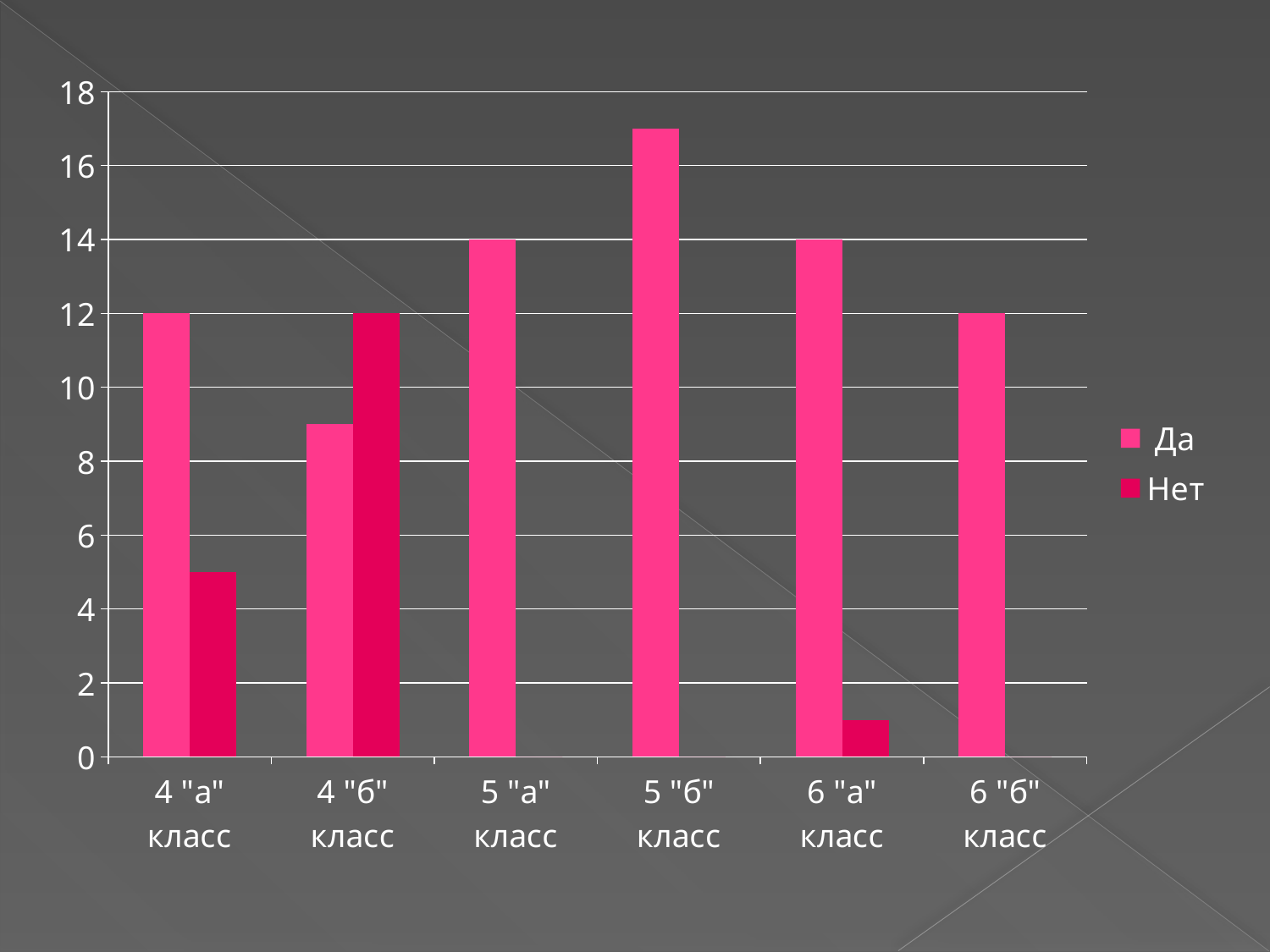
Which class has the larger value for Да: 4 "а" класс or 4 "б" класс? 4 "а" класс What is the value for Нет in 4 "б" класс? 12 What kind of chart is shown on the slide? bar chart What is the value for Да in 5 "а" класс? 14 What is the difference between the Да values for 5 "а" класс and 4 "а" класс? 2 How many classes are shown along the x axis? 6 Is the value for Да in 5 "б" класс greater or less than 16? greater Is the value for Нет in 4 "а" класс greater or less than 6? less How many series does the legend list? 2 Which class has the lowest value for Да? 4 "б" класс What is the value for Да in 4 "а" класс? 12 Which class has the highest value for Да? 5 "б" класс